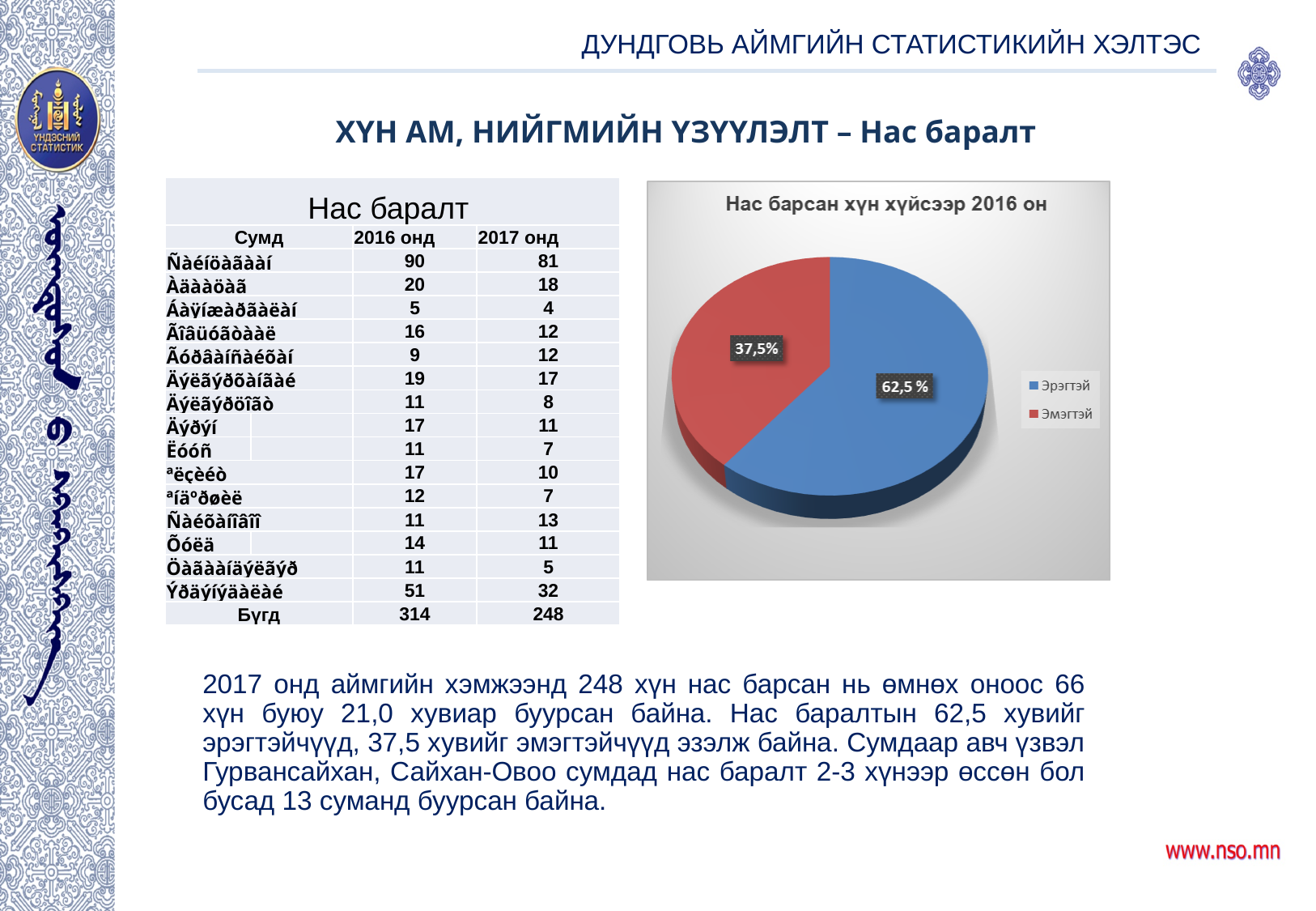
Which slice of the pie chart is the largest? Эрэгтэй How many slices does the pie chart have? 2 What kind of chart is shown on the slide? pie chart What colour is the Эрэгтэй slice in the pie chart? blue In the pie chart, what share is labelled for Эмэгтэй? 37,5% Which slice of the pie chart is the smallest? Эмэгтэй In the pie chart, what share is labelled for Эрэгтэй? 62,5 % How many entries does the legend of the pie chart list? 2 What is the difference in percentage points between the Эрэгтэй and Эмэгтэй slices in the pie chart? 25 percentage points In the pie chart, which is larger, the Эрэгтэй slice or the Эмэгтэй slice? Эрэгтэй What is the title of the pie chart? Нас барсан хүн хүйсээр 2016 он